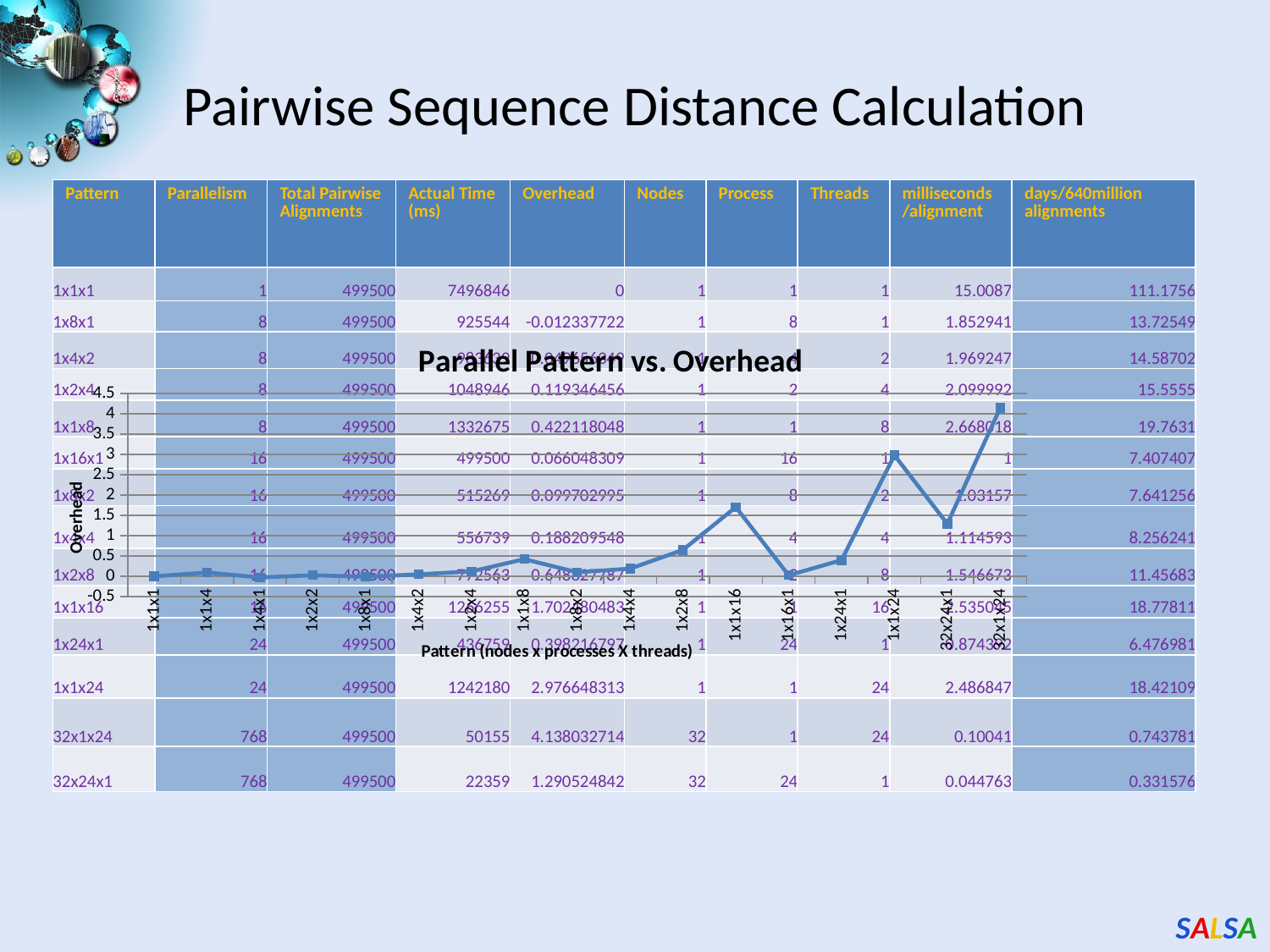
Is the overhead for 1x1x16 greater or less than 1.5? greater What type of chart is shown on the slide? line chart Which has the higher overhead, 32x1x24 or 1x1x24? 32x1x24 What is the label of the chart's y axis? Overhead Which pattern has the highest overhead in the chart? 32x1x24 How many patterns are plotted along the x axis of the chart? 17 Is the overhead for 1x24x1 greater or less than 1? less What is the title of the chart? Parallel Pattern vs. Overhead Which has the higher overhead, 1x1x16 or 32x24x1? 1x1x16 Is the overhead for 32x1x24 greater or less than 3.5? greater